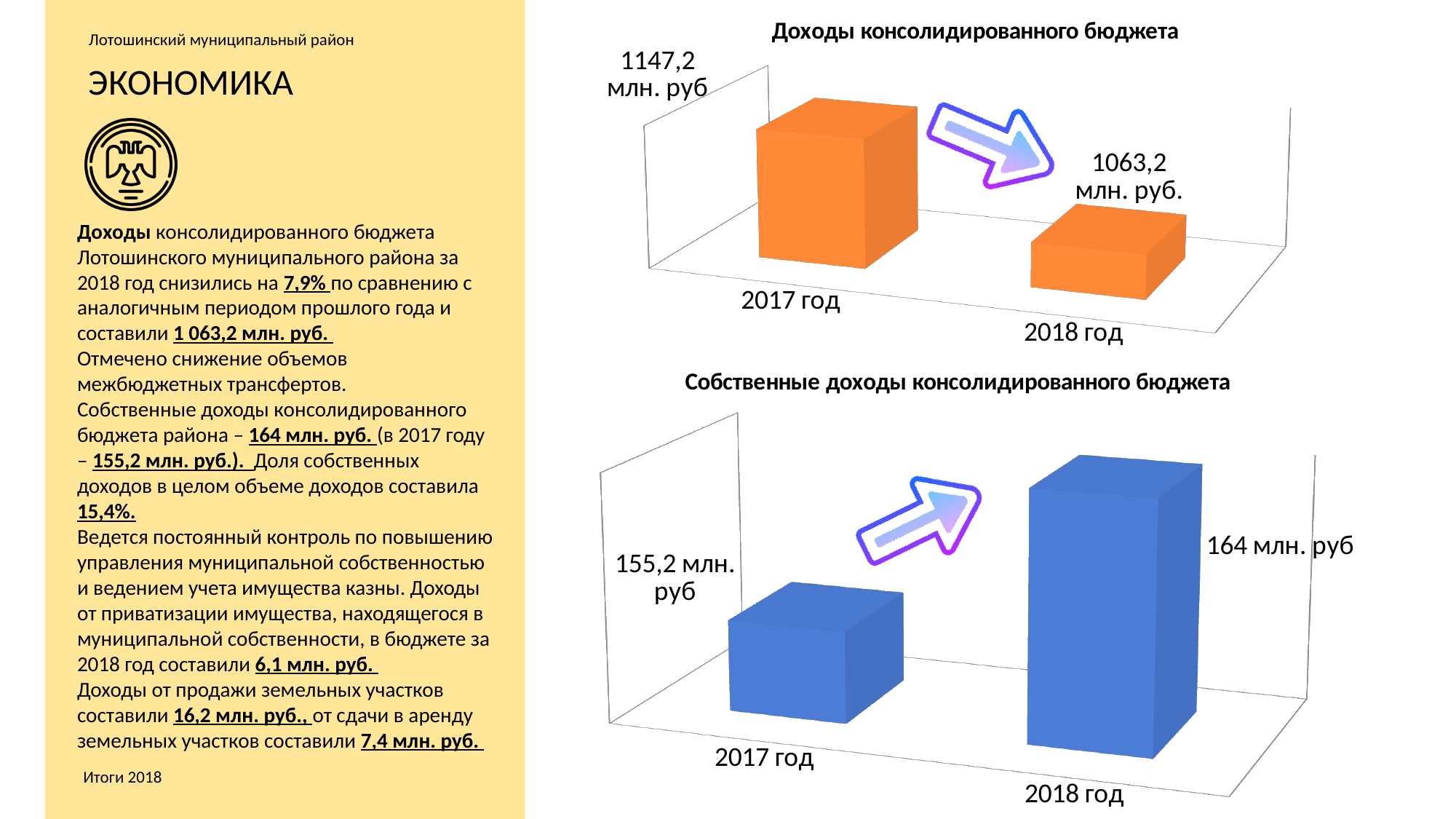
In the chart titled 'Доходы консолидированного бюджета', do the values rise or fall from 2017 год to 2018 год? fall In the chart titled 'Собственные доходы консолидированного бюджета', what is the value for 2018 год? 164 млн. руб In the chart titled 'Собственные доходы консолидированного бюджета', what is the value for 2017 год? 155,2 млн. руб In the chart titled 'Доходы консолидированного бюджета', what is the value for 2017 год? 1147,2 млн. руб What type of chart is the bottom chart titled 'Собственные доходы консолидированного бюджета'? bar chart In the chart titled 'Собственные доходы консолидированного бюджета', do the values rise or fall from 2017 год to 2018 год? rise In the chart titled 'Доходы консолидированного бюджета', which year has the higher value? 2017 год In the chart titled 'Собственные доходы консолидированного бюджета', which year has the lower value? 2017 год In the chart titled 'Доходы консолидированного бюджета', what is the value for 2018 год? 1063,2 млн. руб. How many categories are shown in the chart titled 'Доходы консолидированного бюджета'? 2 In the chart titled 'Доходы консолидированного бюджета', by how much did the value fall from 2017 год to 2018 год? 84 млн. руб. In the chart titled 'Собственные доходы консолидированного бюджета', what is the difference between the 2018 год and 2017 год values? 8,8 млн. руб